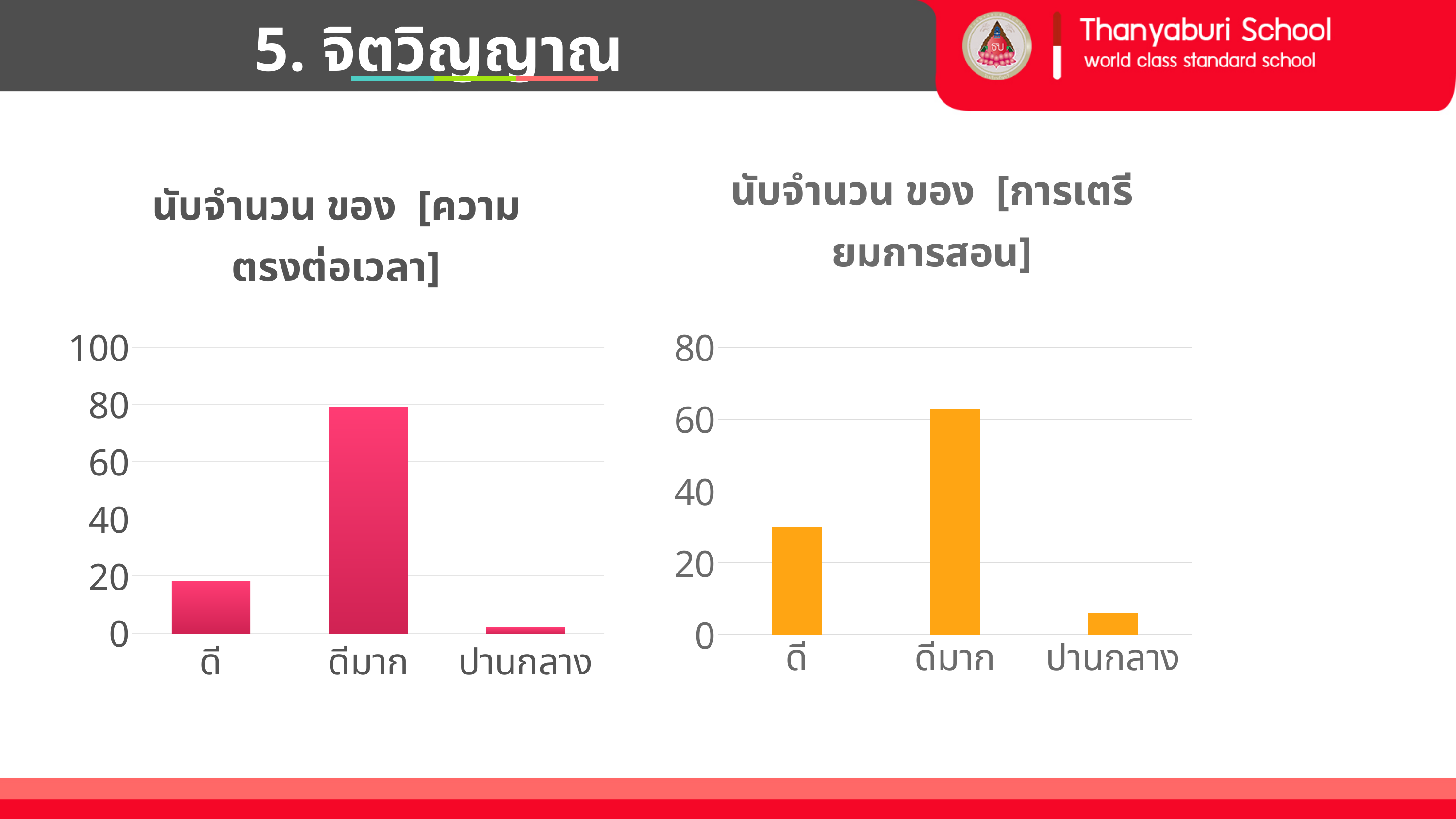
In the left chart (นับจำนวน ของ [ความตรงต่อเวลา]), is the value for ดีมาก greater or less than 60? greater In the right chart (นับจำนวน ของ [การเตรียมการสอน]), which is larger, the value for ดี or the value for ดีมาก? ดีมาก What colour are the bars in the right chart (นับจำนวน ของ [การเตรียมการสอน])? Orange In the left chart (นับจำนวน ของ [ความตรงต่อเวลา]), how many categories are shown on the x axis? 3 In the left chart (นับจำนวน ของ [ความตรงต่อเวลา]), which category has the highest value? ดีมาก In the left chart (นับจำนวน ของ [ความตรงต่อเวลา]), which category has the lowest value? ปานกลาง In the right chart (นับจำนวน ของ [การเตรียมการสอน]), which category has the highest value? ดีมาก What type of chart is the left chart (นับจำนวน ของ [ความตรงต่อเวลา])? Bar chart In the right chart (นับจำนวน ของ [การเตรียมการสอน]), is the value for ปานกลาง greater or less than 20? less In the right chart (นับจำนวน ของ [การเตรียมการสอน]), which category has the lowest value? ปานกลาง In the right chart (นับจำนวน ของ [การเตรียมการสอน]), is the value for ดีมาก greater or less than 60? greater